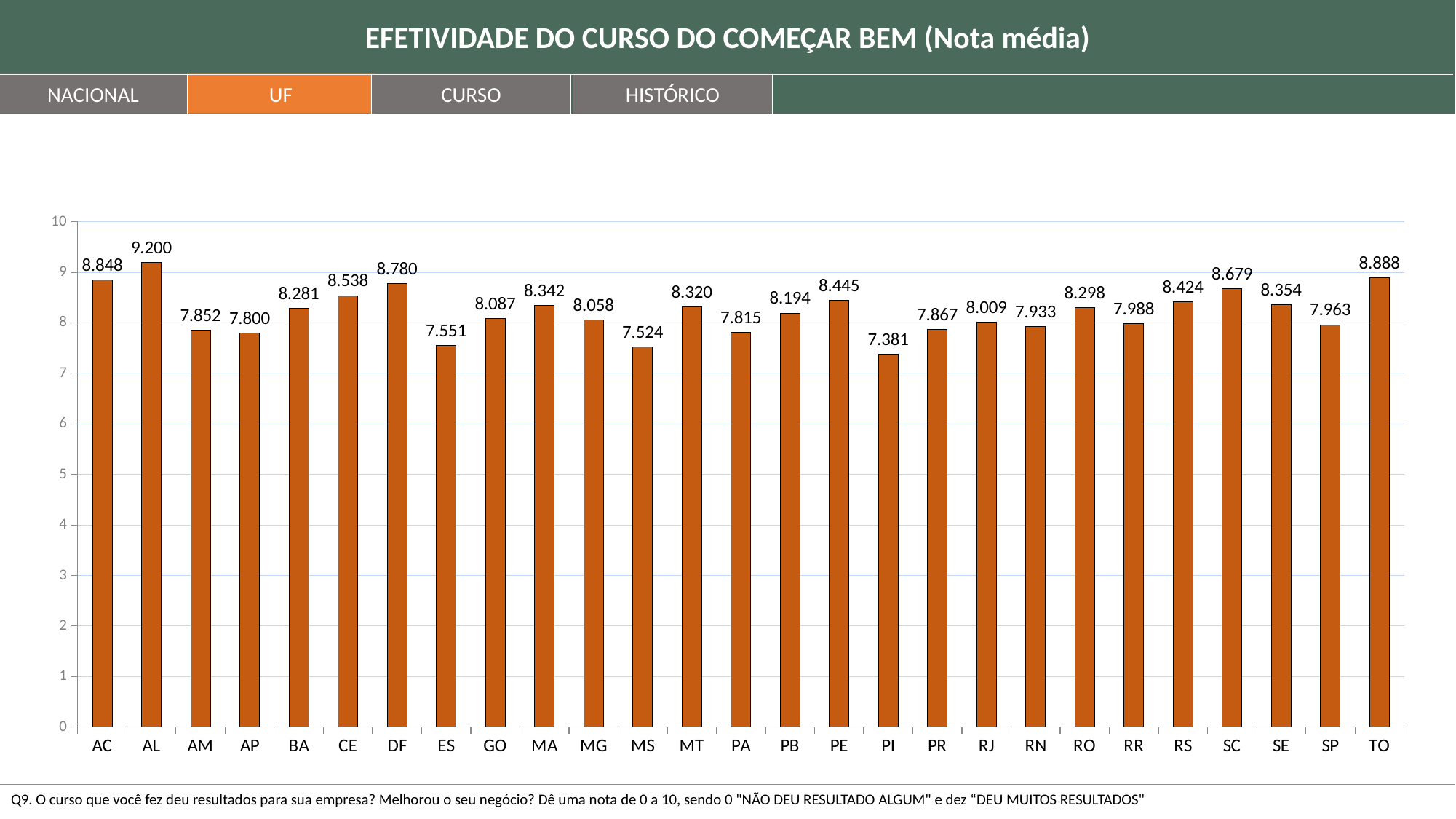
How many UFs (categories) are shown on the x axis? 27 What is the value shown for PI? 7.381 Which has a higher value, MS or ES? ES Which UF has the lowest average score? PI Which has a higher value, DF or CE? DF What kind of chart is shown on the slide? Bar chart What is the average score (nota média) for SC? 8.679 Which UF has the highest average score? AL What is the difference between the values for AL and PI? 1.819 What is the title of the chart? EFETIVIDADE DO CURSO DO COMEÇAR BEM (Nota média) What is the difference between the values for TO and AC? 0.040 What is the value shown for MT? 8.320